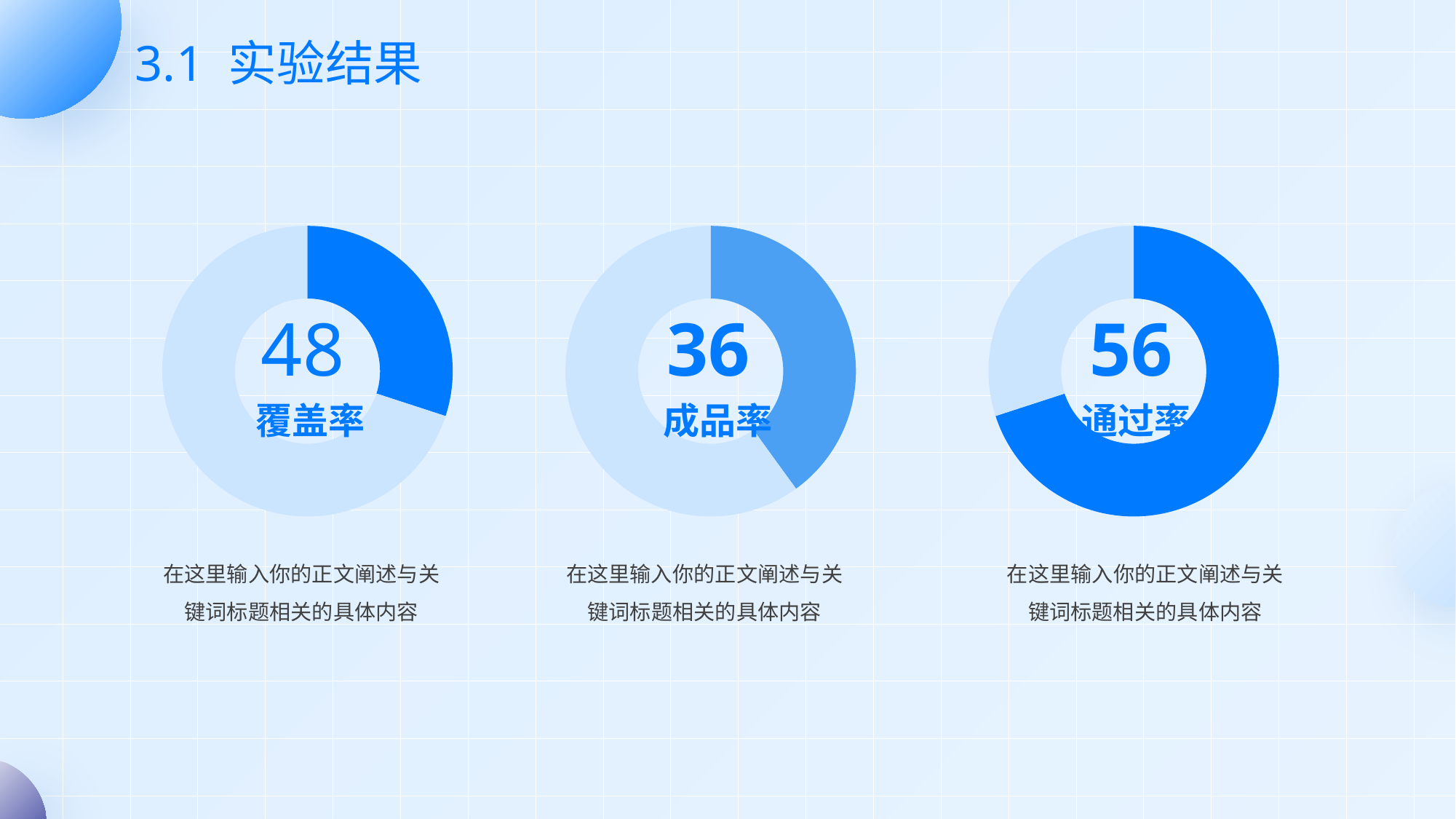
What kind of chart is used for 覆盖率, 成品率 and 通过率? Donut (pie) chart How many donut charts are shown on the slide? 3 What value is shown in the centre of the 覆盖率 chart? 48 Which of the three charts shows the highest value? 通过率 Which is larger, the 覆盖率 value or the 成品率 value? 覆盖率 Which of the three charts shows the lowest value? 成品率 What is the title of the slide containing the three charts? 3.1 实验结果 What value is shown in the centre of the 通过率 chart? 56 What is the difference between the 通过率 value and the 成品率 value? 20 What is the difference between the 通过率 value and the 覆盖率 value? 8 What value is shown in the centre of the 成品率 chart? 36 What is the difference between the 覆盖率 value and the 成品率 value? 12